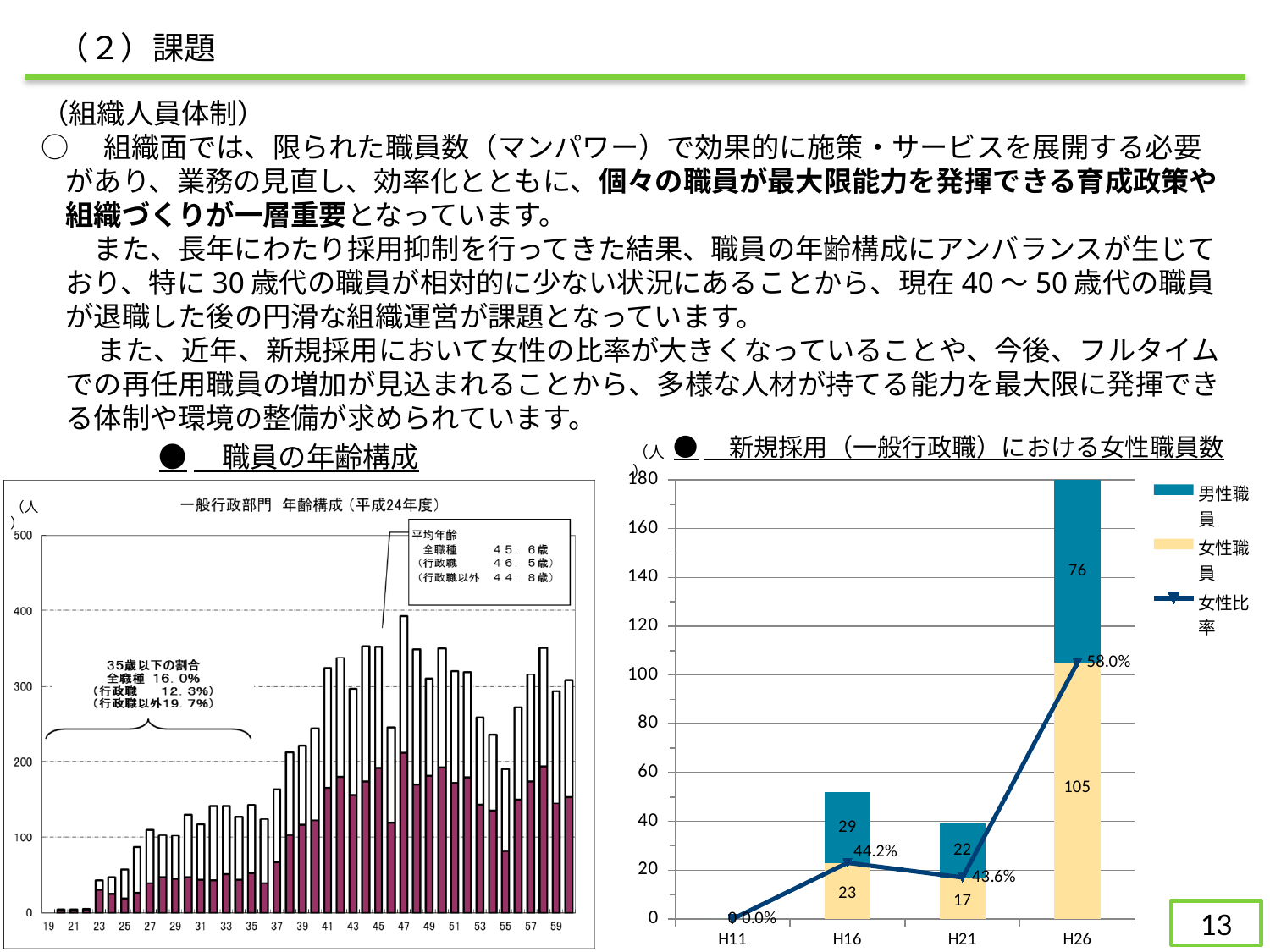
In the chart titled 新規採用（一般行政職）における女性職員数, which year has the lowest 女性比率? H11 In the chart titled 新規採用（一般行政職）における女性職員数, how many years are shown on the x axis? 4 In the chart titled 新規採用（一般行政職）における女性職員数, what is the value for 女性職員 in H26? 105 In the chart titled 新規採用（一般行政職）における女性職員数, what is the value for 男性職員 in H16? 29 In the chart titled 職員の年齢構成, what is the 平均年齢 for 全職種 shown in the annotation box? 45.6歳 In the chart titled 新規採用（一般行政職）における女性職員数, which is larger: 男性職員 in H16 or 男性職員 in H21? 男性職員 in H16 In the chart titled 職員の年齢構成, is the value for age 47 greater or less than 300? greater In the chart titled 新規採用（一般行政職）における女性職員数, what is the 女性比率 for H21? 43.6% In the chart titled 新規採用（一般行政職）における女性職員数, how many series does the legend list? 3 In the chart titled 新規採用（一般行政職）における女性職員数, which year has the highest 女性比率? H26 In the chart titled 新規採用（一般行政職）における女性職員数, what is the difference between 女性職員 in H26 and 女性職員 in H16? 82 In the chart titled 新規採用（一般行政職）における女性職員数, what is the total of the stacked bar for H21? 39